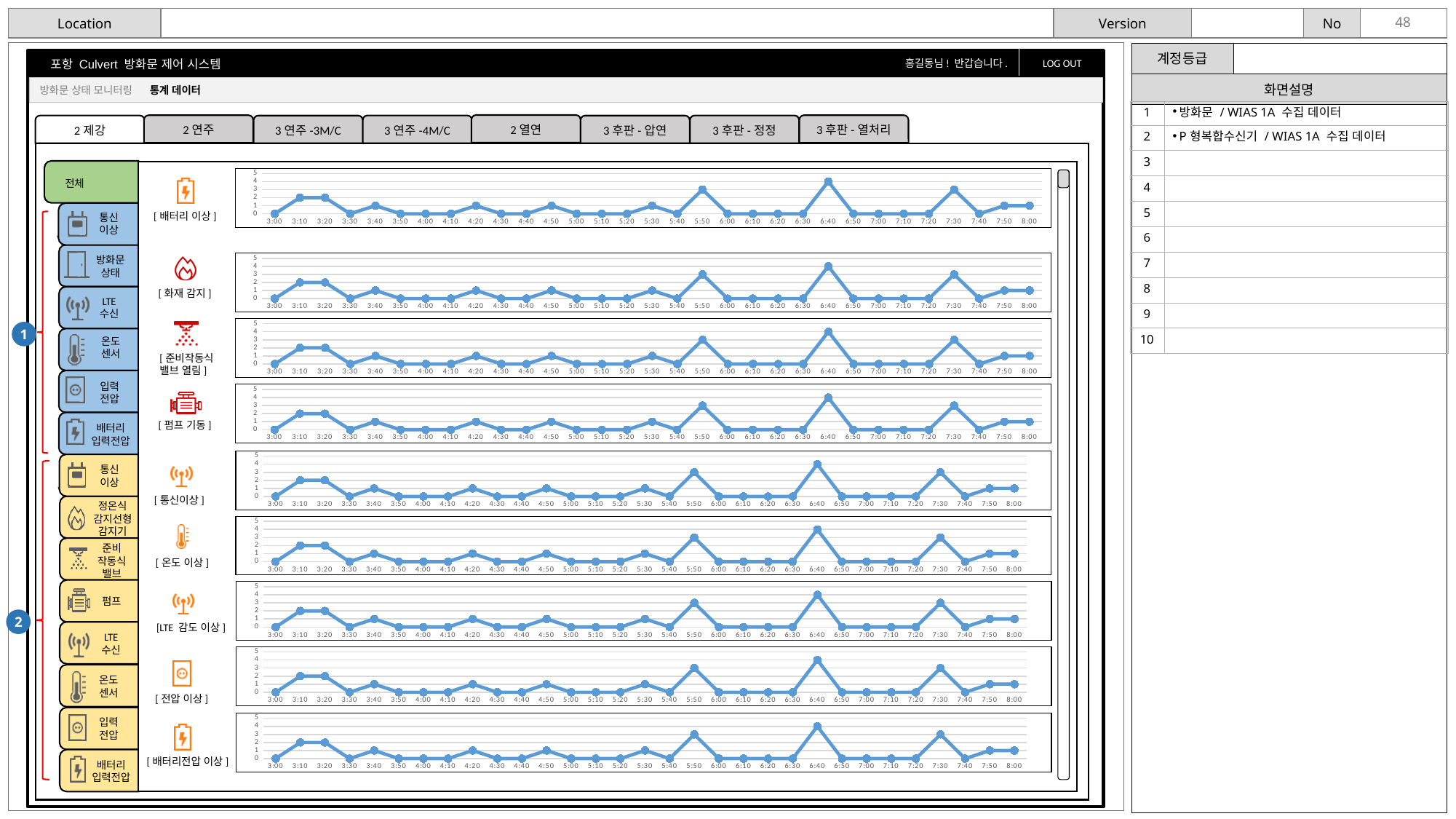
In the [배터리 이상] chart, does the line rise or fall between 6:40 and 6:50? fall What kind of chart is the [배터리 이상] chart? line chart In the [통신이상] chart, is the value at 5:50 greater or less than 2? greater In the [화재 감지] chart, what is the value at 6:40? 4 What is the maximum value shown on the y axis of the [준비작동식 밸브 열림] chart? 5 In the [펌프 기동] chart, what is the value at 3:00? 0 In the [배터리 이상] chart, at which time does the line reach its highest value? 6:40 In the [온도 이상] chart, is the value at 6:00 greater or less than 2? less How many line charts are shown in the statistics panel on the slide? 9 How many time points are plotted along the x axis of the [전압 이상] chart? 31 What is the first time label on the x axis of the [배터리전압 이상] chart? 3:00 In the [LTE 감도 이상] chart, which is larger, the value at 6:40 or the value at 7:30? 6:40